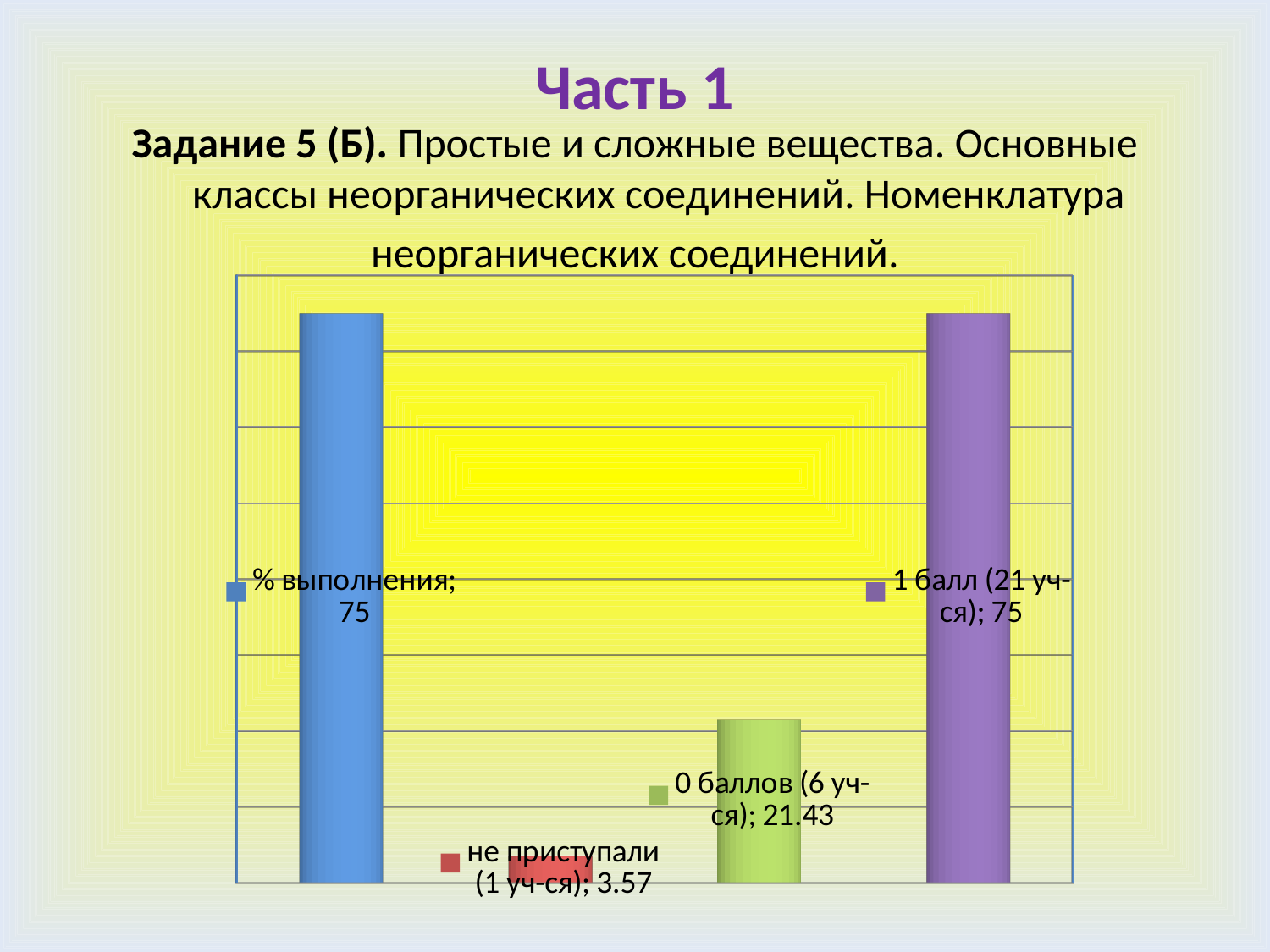
What is the difference between the values for "1 балл (21 уч-ся)" and "0 баллов (6 уч-ся)"? 53.57 How many students are indicated in the label for "1 балл"? 21 What is the value shown for "0 баллов (6 уч-ся)"? 21.43 What colour is the bar for "0 баллов (6 уч-ся)"? green Which is larger: the value for "0 баллов (6 уч-ся)" or the value for "не приступали (1 уч-ся)"? 0 баллов (6 уч-ся) What is the value shown for "% выполнения"? 75 What is the value shown for "1 балл (21 уч-ся)"? 75 What kind of chart is shown on the slide? bar chart What is the value shown for "не приступали (1 уч-ся)"? 3.57 How many bars are plotted in the chart? 4 Which category has the lowest value in the chart? не приступали (1 уч-ся) What is the difference between the values for "0 баллов (6 уч-ся)" and "не приступали (1 уч-ся)"? 17.86